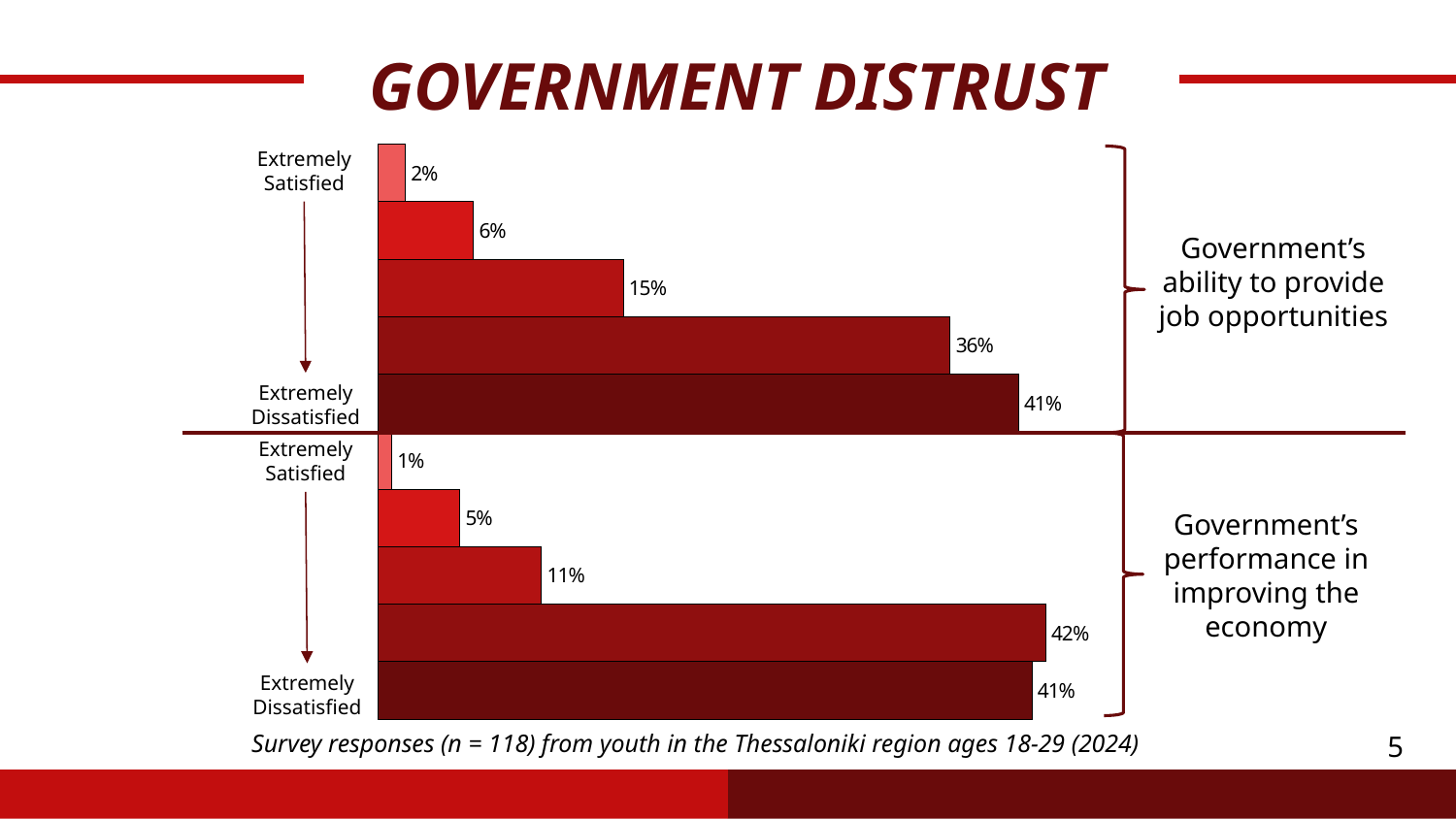
In the chart for Government's ability to provide job opportunities, which response category has the highest percentage? Extremely Dissatisfied In the chart for Government's ability to provide job opportunities, what percentage of respondents were Extremely Dissatisfied? 41% How many bars are in the chart for Government's ability to provide job opportunities? 5 In the chart for Government's performance in improving the economy, what is the highest percentage shown on any bar? 42% What type of chart is used on this slide? Bar chart In the chart for Government's performance in improving the economy, what percentage of respondents were Extremely Satisfied? 1% In the chart for Government's ability to provide job opportunities, what is the difference in percentage points between Extremely Dissatisfied and Extremely Satisfied? 39 In the chart for Government's performance in improving the economy, what percentage of respondents were Extremely Dissatisfied? 41% In the chart for Government's performance in improving the economy, do the percentages generally rise or fall moving from Extremely Satisfied toward Extremely Dissatisfied? Rise In the chart for Government's performance in improving the economy, which response category has the lowest percentage? Extremely Satisfied In the chart for Government's ability to provide job opportunities, what percentage of respondents were Extremely Satisfied? 2% Which is larger: the Extremely Satisfied percentage for Government's ability to provide job opportunities or for Government's performance in improving the economy? Government's ability to provide job opportunities